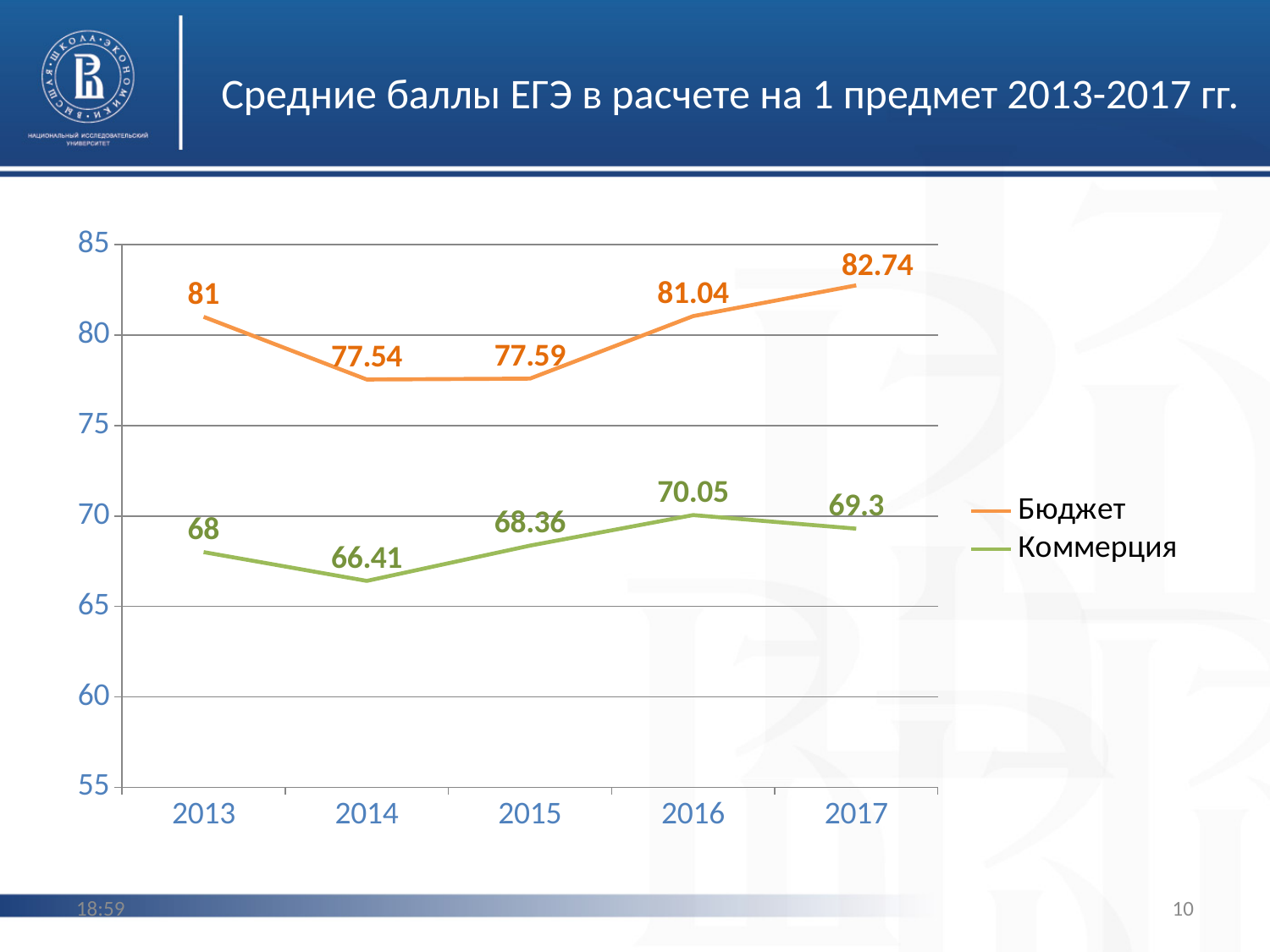
What is the difference between the Бюджет and Коммерция values in 2013? 13 Is the Бюджет value in 2016 greater or less than 80? greater What kind of chart is shown on the slide? line chart Which is larger: the Коммерция value in 2016 or in 2017? 2016 What is the value for Бюджет in 2015? 77.59 How many series does the legend list? 2 Does the Бюджет series rise or fall from 2015 to 2017? rise In which year is the Бюджет value lowest? 2014 What is the value for Бюджет in 2017? 82.74 How many years are shown on the x axis? 5 In which year is the Коммерция value highest? 2016 What is the value for Коммерция in 2014? 66.41